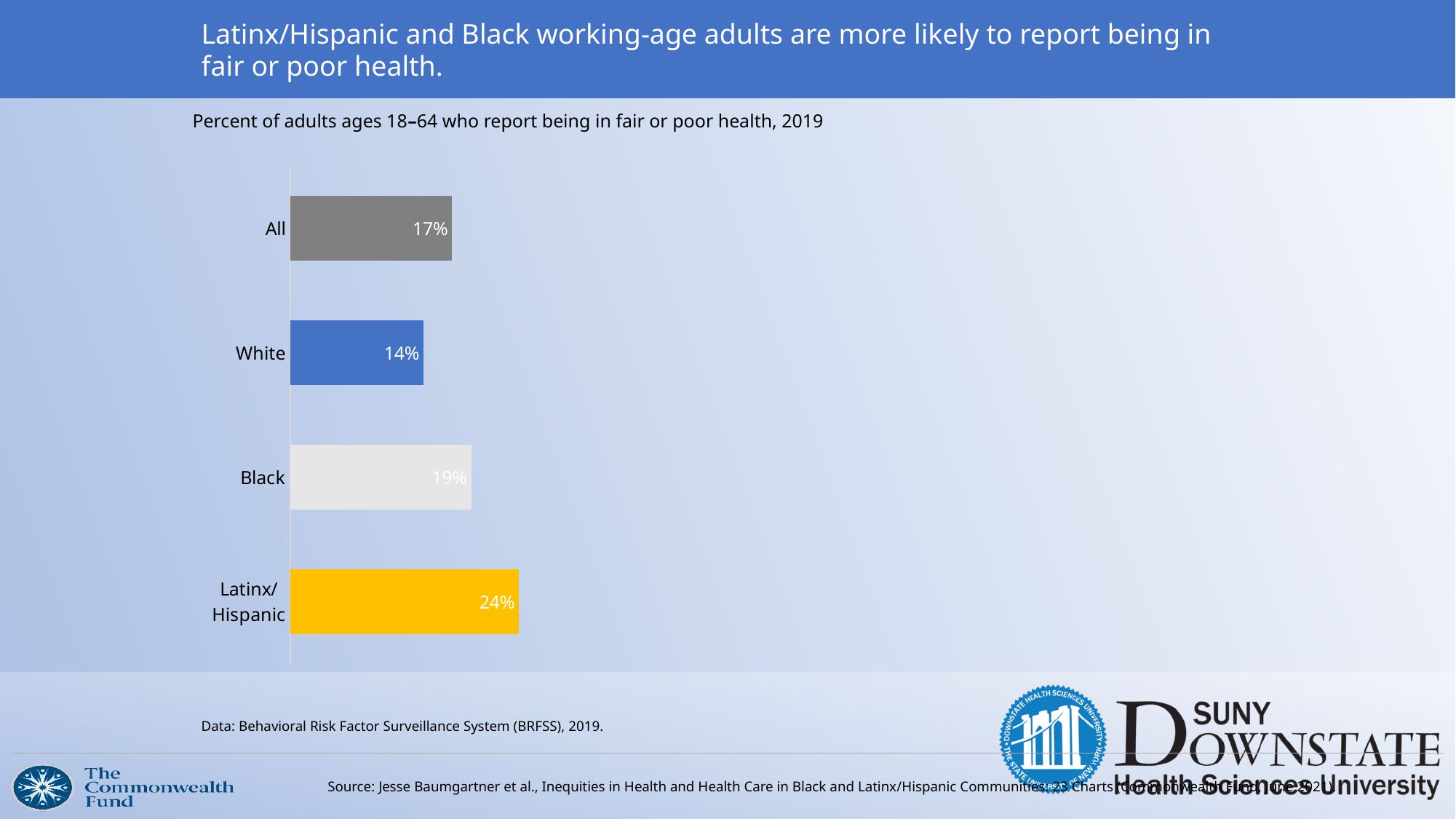
What colour is the bar for Latinx/Hispanic adults? Yellow What is the value shown for Latinx/Hispanic adults? 24% What is the difference in percentage points between Black and All adults? 2 percentage points What is the difference in percentage points between Latinx/Hispanic and White adults? 10 percentage points What is the value shown for the All category? 17% Which category has the lowest percent reporting fair or poor health? White What percent of White adults ages 18–64 report being in fair or poor health? 14% Which category has the highest percent reporting fair or poor health? Latinx/Hispanic What is the value shown for Black adults? 19% How many categories are shown in the chart? 4 Which is larger, the value for Black adults or the value for White adults? Black What kind of chart is shown on the slide? Bar chart